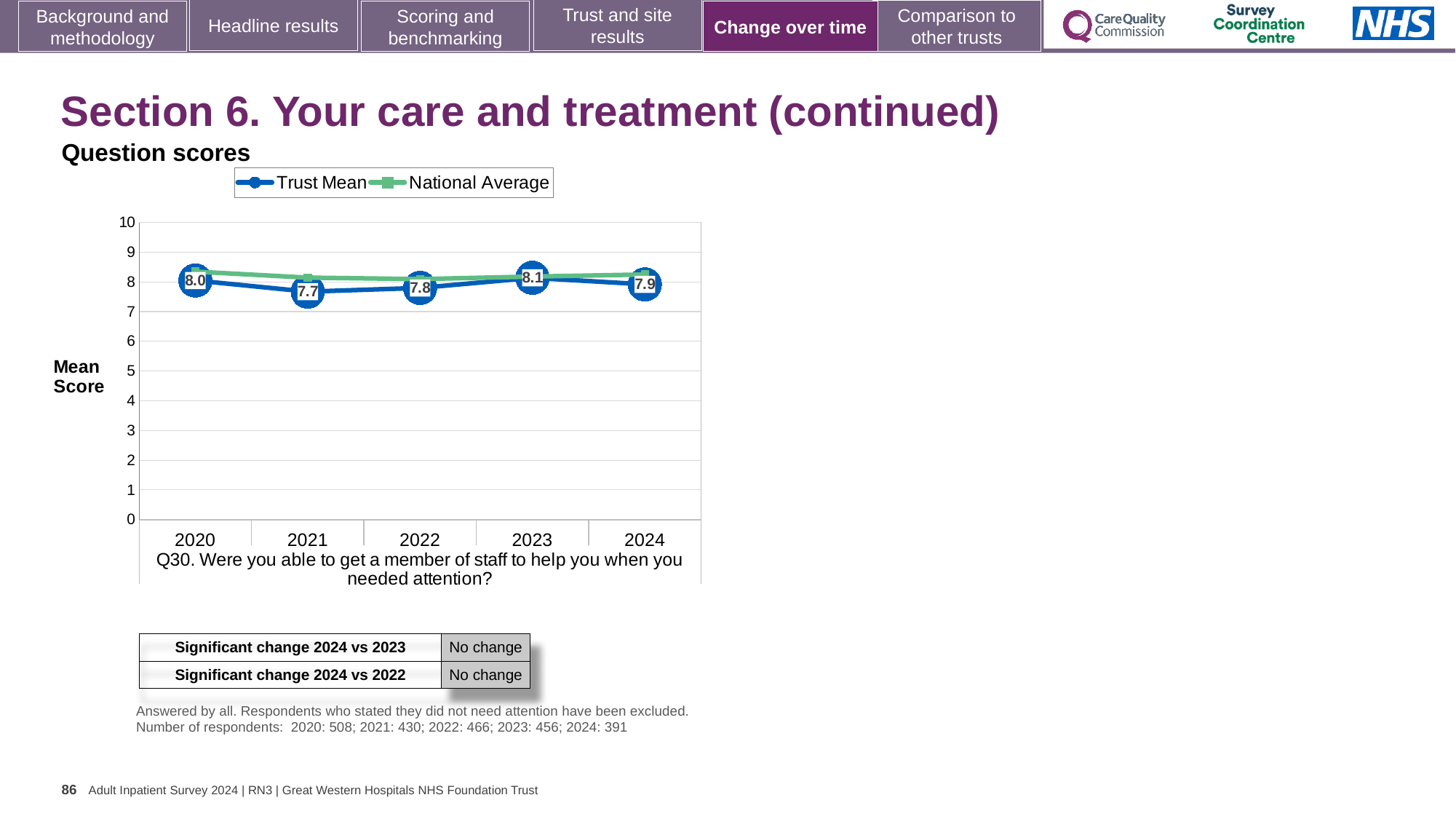
In which year is the Trust Mean highest? 2023 In which year is the Trust Mean lowest? 2021 What is the Trust Mean score for 2021? 7.7 How many years are shown on the x axis? 5 Which is larger, the Trust Mean for 2020 or for 2022? 2020 Does the Trust Mean rise or fall from 2020 to 2021? Fall What is the Trust Mean score for 2024? 7.9 Is the National Average value for 2021 greater or less than 9? less How many series does the legend list? 2 What is the difference between the Trust Mean in 2023 and in 2021? 0.4 What kind of chart is shown on the slide? Line chart What is the Trust Mean score for 2023? 8.1